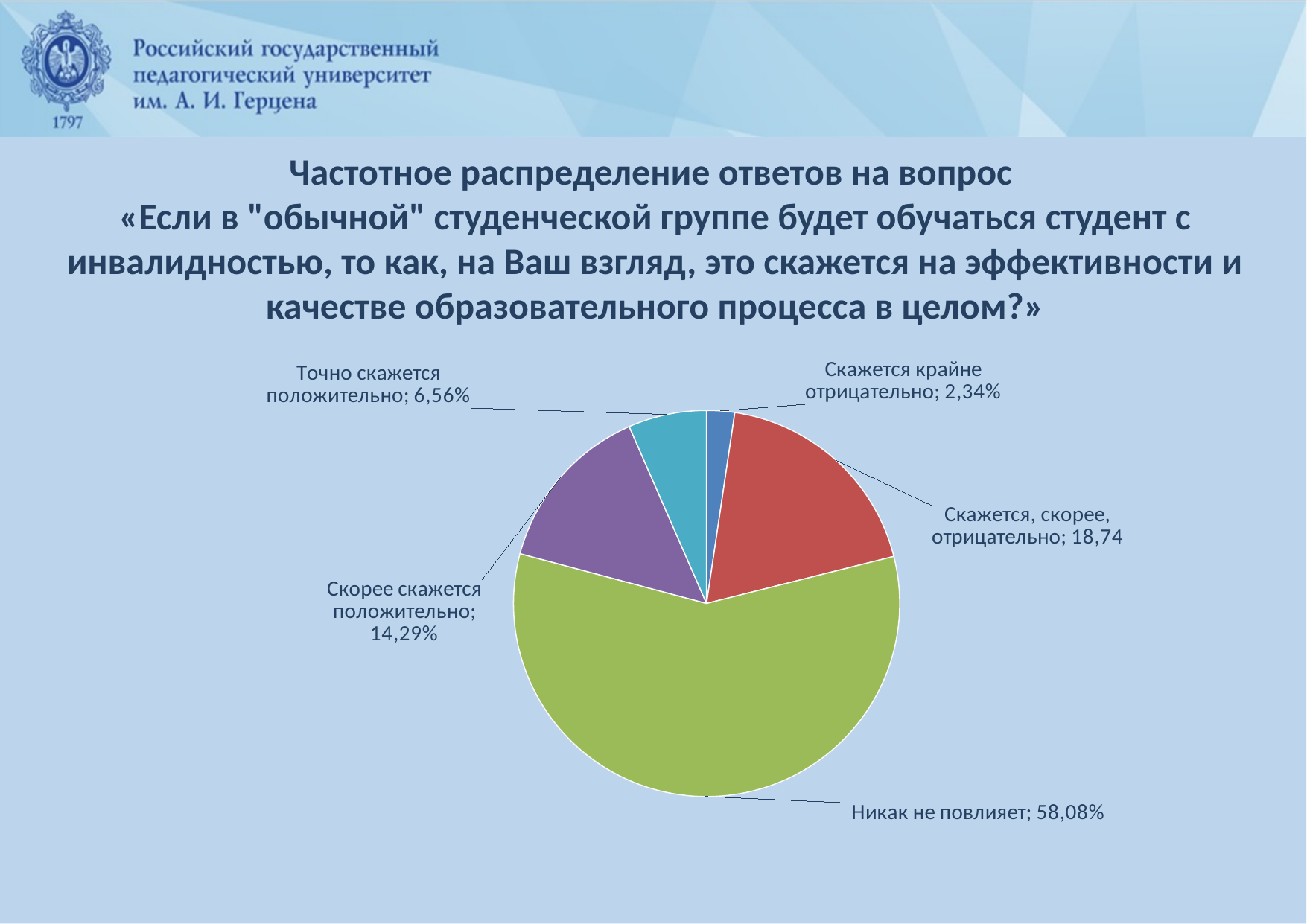
What is the value shown for "Никак не повлияет"? 58,08% What is the value shown for "Точно скажется положительно"? 6,56% What is the difference between the shares for "Скорее скажется положительно" and "Точно скажется положительно"? 7,73% What is the value shown for "Скорее скажется положительно"? 14,29% Which is larger: the share for "Скорее скажется положительно" or for "Точно скажется положительно"? Скорее скажется положительно What is the value shown for "Скажется крайне отрицательно"? 2,34% What colour is the slice for "Никак не повлияет"? green How many slices does the pie chart have? 5 Which answer option has the largest share of the pie? Никак не повлияет What kind of chart is shown on the slide? pie chart What is the value shown for "Скажется, скорее, отрицательно"? 18,74 Which answer option has the smallest share of the pie? Скажется крайне отрицательно